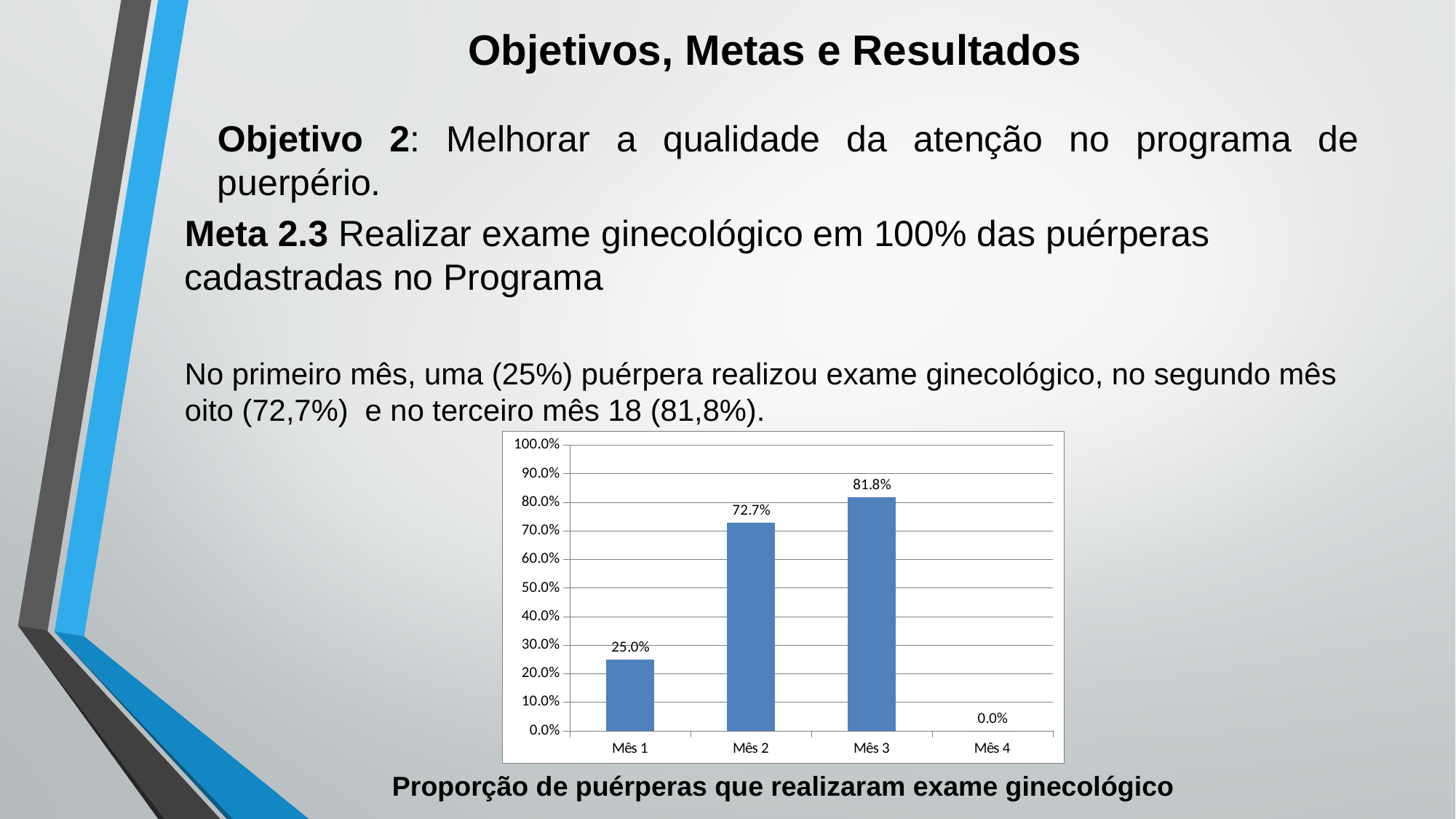
Which category has the highest value? Mês 3 What is the value for Mês 3? 81.8% Which is larger, the value for Mês 1 or the value for Mês 2? Mês 2 What is the value for Mês 1? 25.0% What is the value for Mês 4? 0.0% What is the value for Mês 2? 72.7% Which category has the lowest value? Mês 4 What is the difference between the values for Mês 2 and Mês 1? 47.7% What is the difference between the values for Mês 3 and Mês 2? 9.1% What kind of chart is shown on the slide? Bar chart How many categories are shown on the x axis? 4 What is the title shown below the chart? Proporção de puérperas que realizaram exame ginecológico